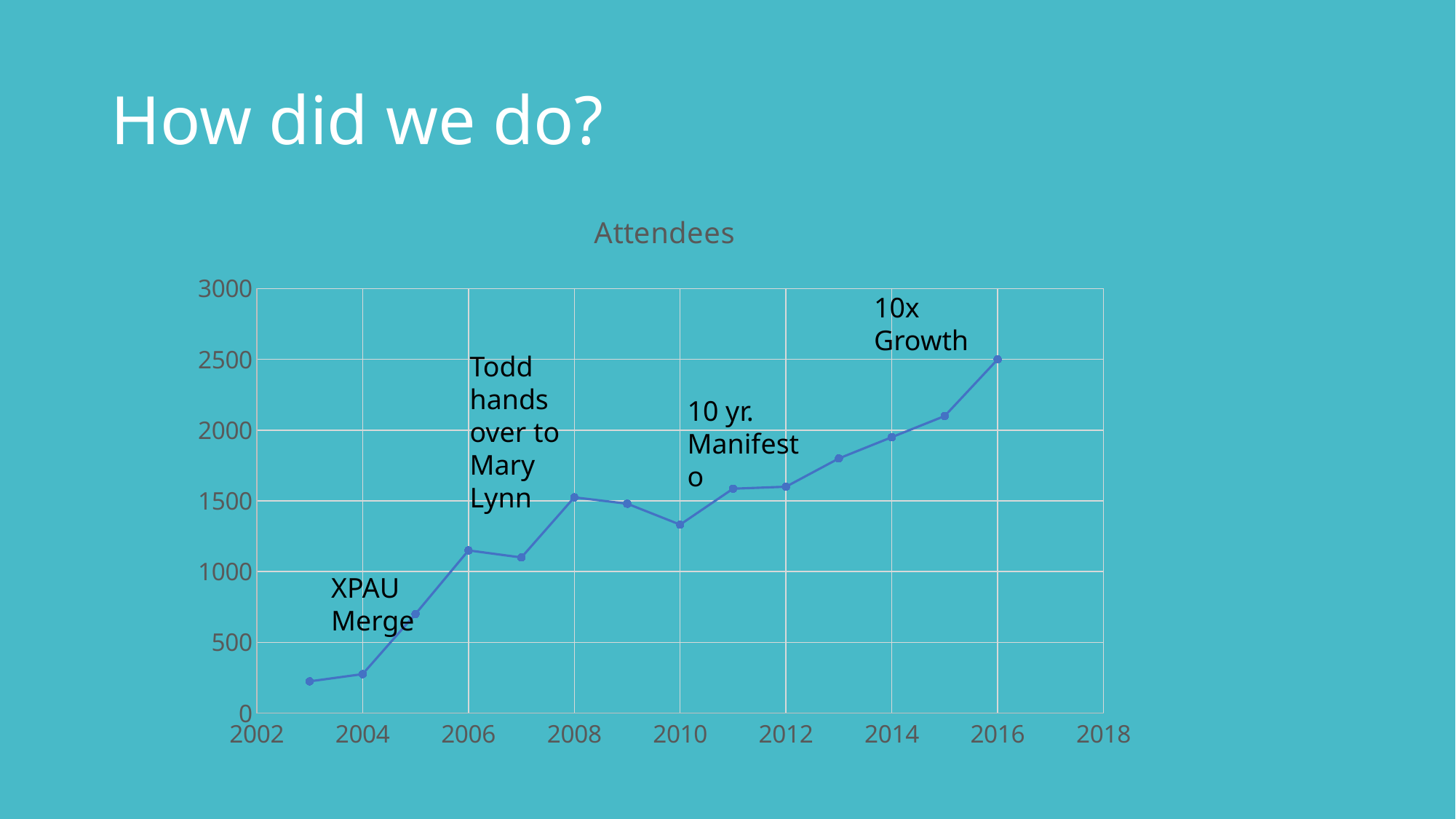
Is the value for 2013 greater or less than 1500? greater Is the value for 2010 greater or less than 1500? less Which year has the highest number of attendees? 2016 What is the title of the chart? Attendees What annotation is placed near the 2004 data point? XPAU Merge Which year has more attendees, 2008 or 2010? 2008 Which year has the lowest number of attendees? 2003 What kind of chart is shown on the slide? Line chart How many data points are plotted on the line? 14 Overall, do attendees rise or fall from 2003 to 2016? rise Is the value for 2005 greater or less than 1000? less